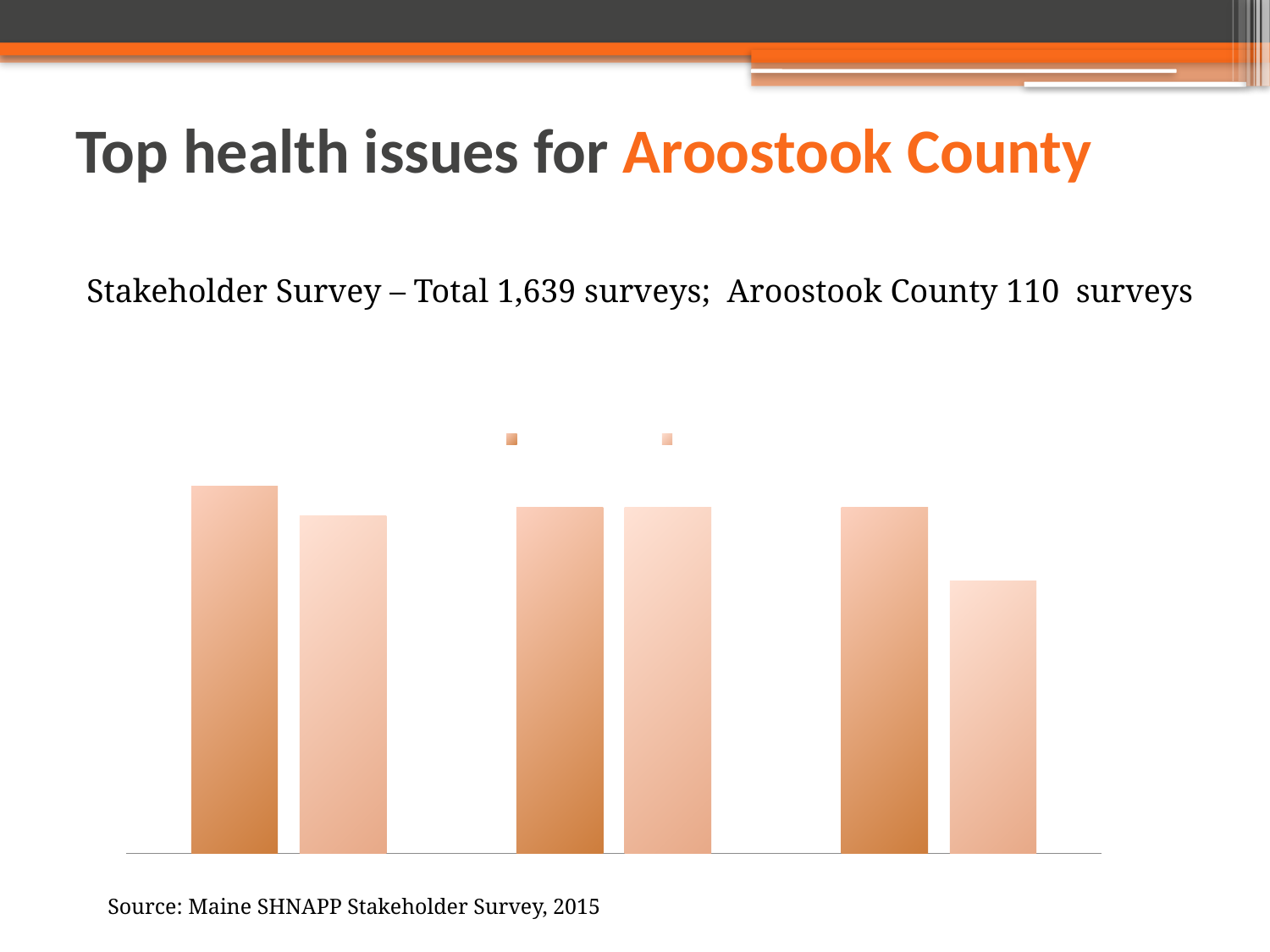
What colour are the bars in the chart? orange How many series does the chart's legend list? 2 Which group of bars contains the shortest bar: the leftmost, middle, or rightmost group? rightmost In the leftmost group of bars, is the darker orange bar taller or shorter than the lighter bar? taller What kind of chart is shown on the slide? bar chart In the rightmost group of bars, is the darker orange bar taller or shorter than the lighter bar? taller How many groups of bars are plotted in the chart? 3 Which group of bars has the tallest single bar: the leftmost, middle, or rightmost group? leftmost How many bars are plotted in total in the chart? 6 Are the bars in the chart vertical or horizontal? vertical